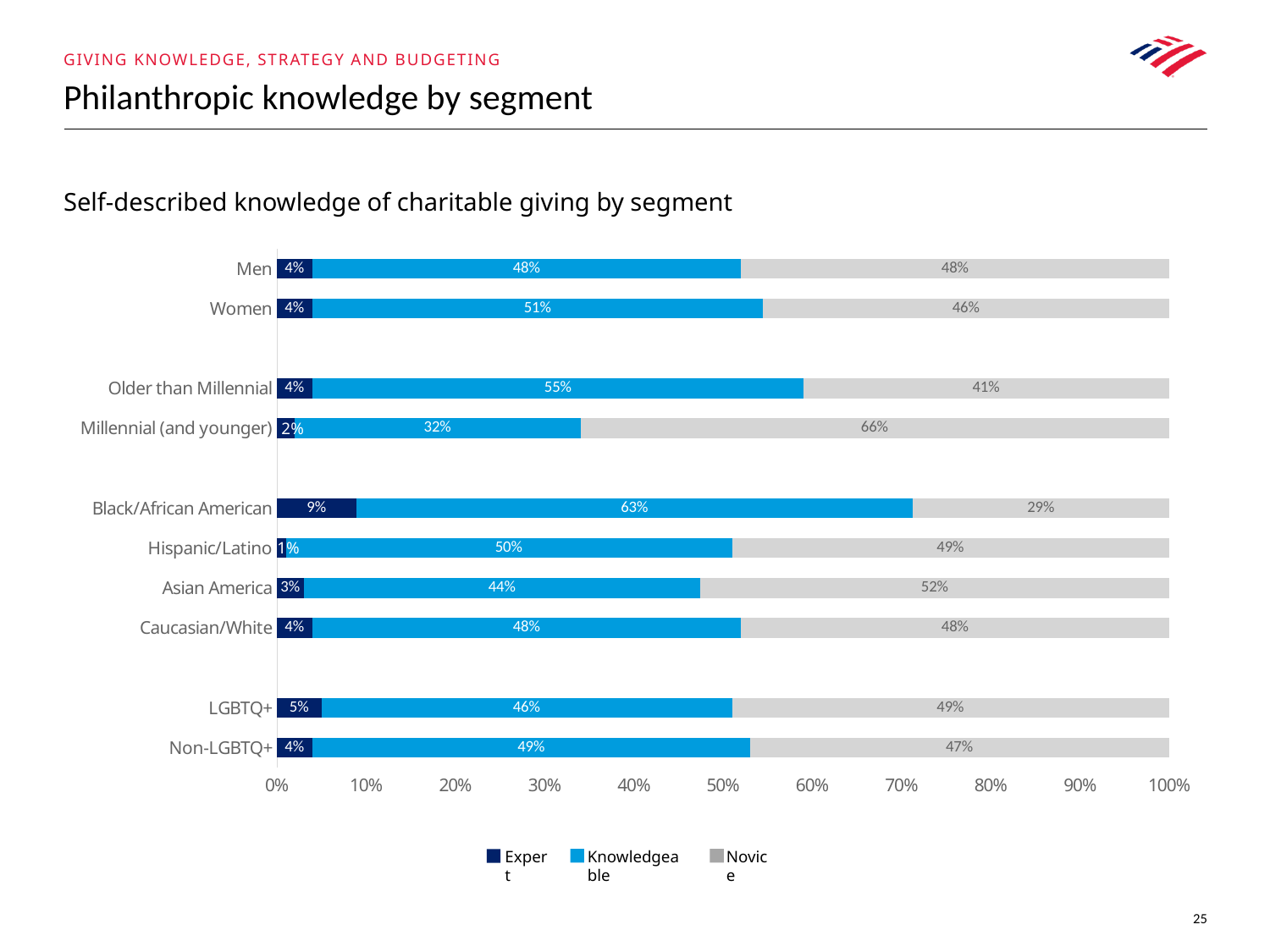
How many series does the legend list? 3 What is the Novice value for Millennial (and younger)? 66% What is the title of the chart? Self-described knowledge of charitable giving by segment What type of chart is shown on the slide? Stacked bar chart What is the difference between the Knowledgeable values for Older than Millennial and Millennial (and younger)? 23% Which segment has the highest Expert percentage? Black/African American Which has a larger Novice share, Asian America or Caucasian/White? Asian America Which segment has the lowest Knowledgeable percentage? Millennial (and younger) What is the Expert value for Hispanic/Latino? 1% How many segments (bars) are shown in the chart? 10 What percentage of Black/African American respondents describe themselves as Knowledgeable? 63% What is the total of the Expert and Knowledgeable values for Women? 55%